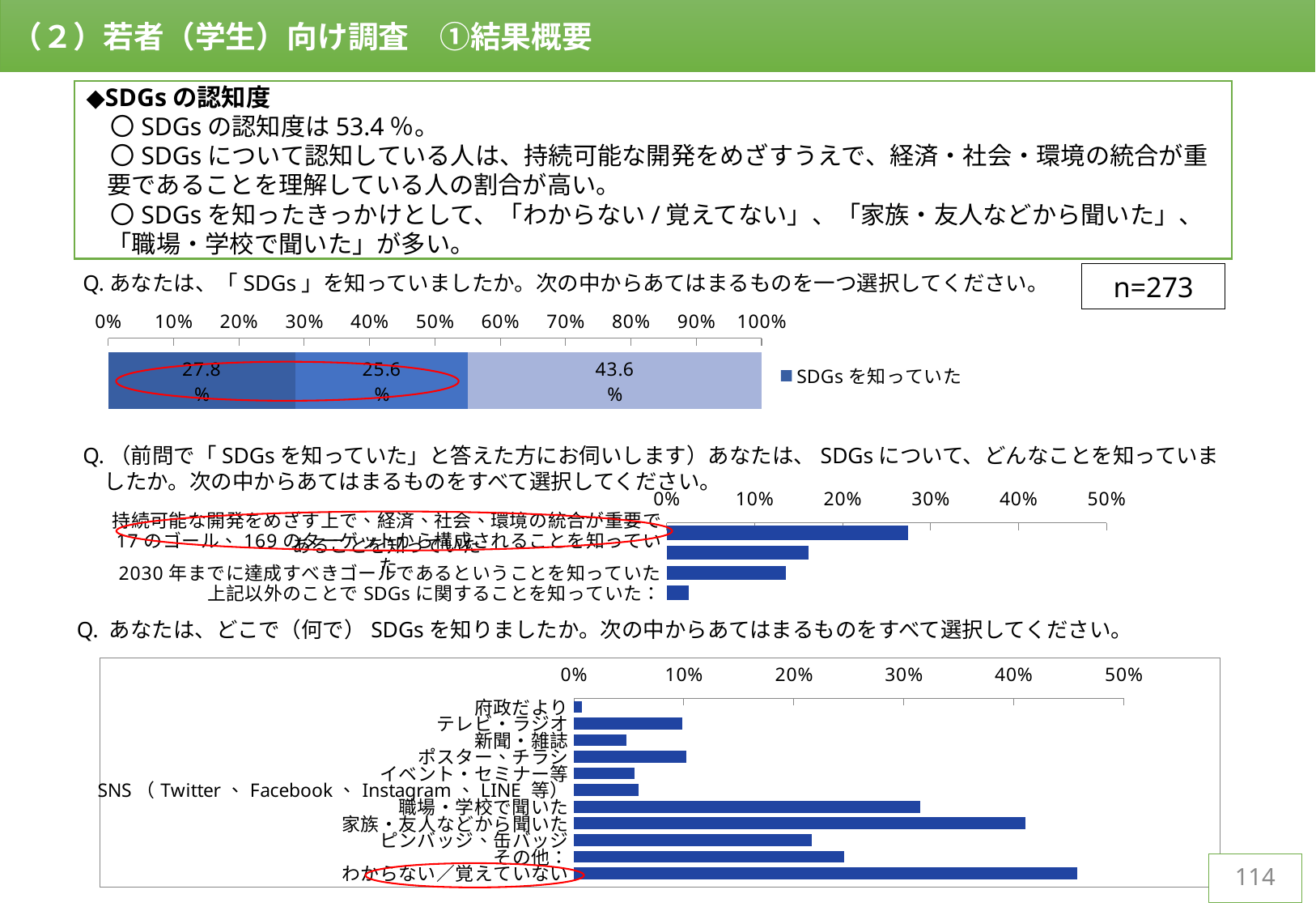
In the bottom bar chart, which is larger: 職場・学校で聞いた or 家族・友人などから聞いた? 家族・友人などから聞いた In the bottom bar chart, which category has the lowest value? 府政だより In the top stacked bar chart (SDGs awareness), what is the value printed on the leftmost (darkest blue) segment? 27.8% In the middle bar chart, is the value for the top category (経済、社会、環境の統合が重要) greater or less than 20%? greater In the middle bar chart, which category has the shortest bar? 上記以外のことでSDGsに関することを知っていた In the top stacked bar chart, which segment has the largest value? The rightmost (lightest blue) segment, 43.6% What kind of chart is the top chart on the slide? Stacked bar chart In the middle bar chart (what respondents knew about SDGs), which category has the longest bar? 持続可能な開発をめざす上で、経済、社会、環境の統合が重要であることを知っていた How many segments does the top stacked bar contain? 3 How many categories are shown in the bottom bar chart? 11 In the bottom bar chart (where respondents learned about SDGs), which category has the highest value? わからない／覚えていない In the top stacked bar chart, what is the difference between the first segment (27.8%) and the second segment (25.6%)? 2.2 percentage points